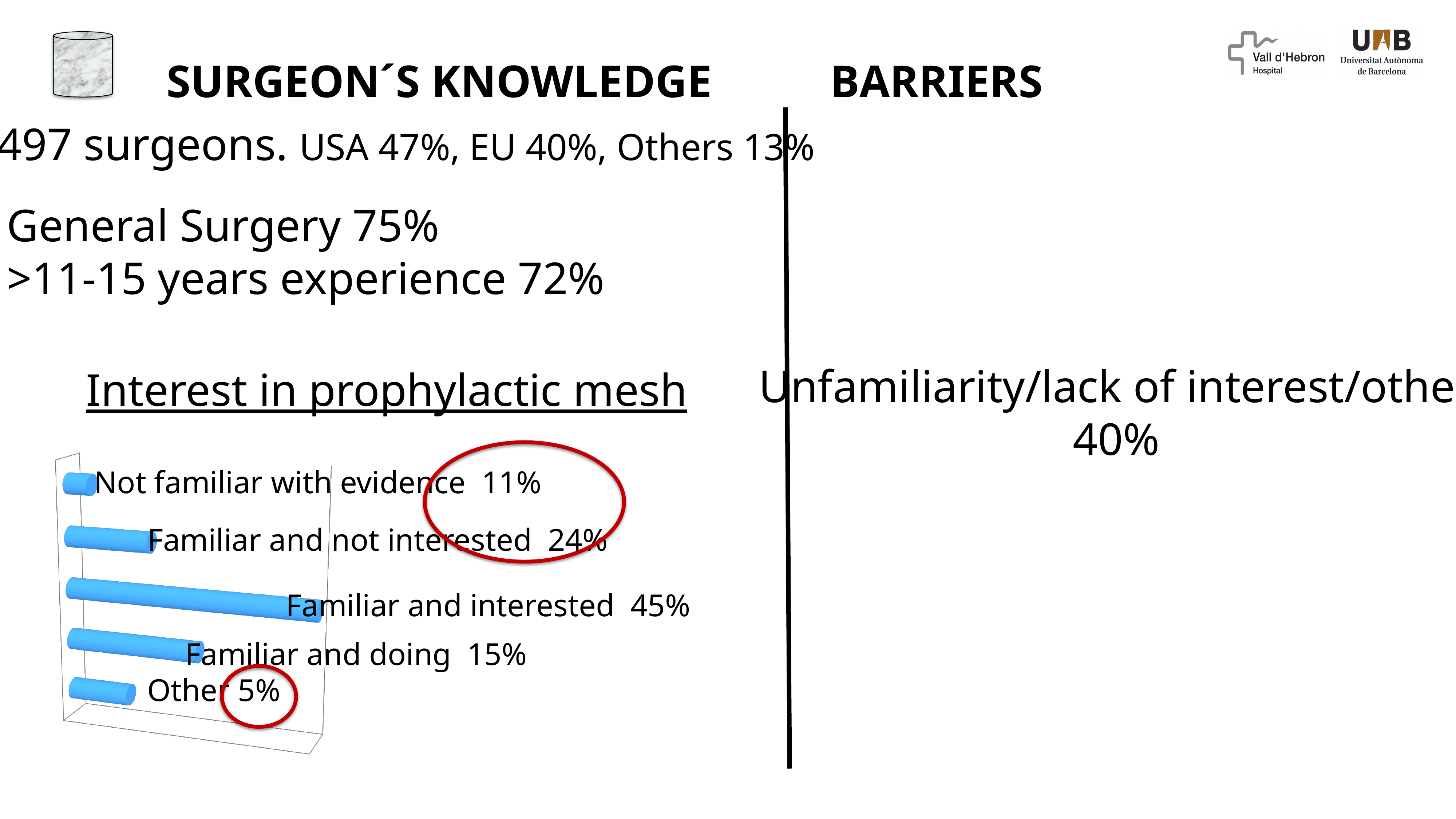
Which category has the lowest value in the Interest in prophylactic mesh chart? Other What percentage of surgeons are 'Familiar and not interested' in the Interest in prophylactic mesh chart? 24% How many categories are shown in the Interest in prophylactic mesh chart? 5 What percentage of surgeons are 'Not familiar with evidence' in the Interest in prophylactic mesh chart? 11% Which is larger in the Interest in prophylactic mesh chart: 'Familiar and doing' or 'Not familiar with evidence'? Familiar and doing What is the difference between 'Familiar and interested' and 'Familiar and not interested' in the Interest in prophylactic mesh chart? 21% What percentage of surgeons are 'Familiar and interested' in the Interest in prophylactic mesh chart? 45% What colour are the bars in the Interest in prophylactic mesh chart? Blue What type of chart is the Interest in prophylactic mesh chart? Bar chart What is the difference between 'Familiar and doing' and 'Other' in the Interest in prophylactic mesh chart? 10% What percentage of surgeons are 'Familiar and doing' in the Interest in prophylactic mesh chart? 15% Which category has the highest value in the Interest in prophylactic mesh chart? Familiar and interested